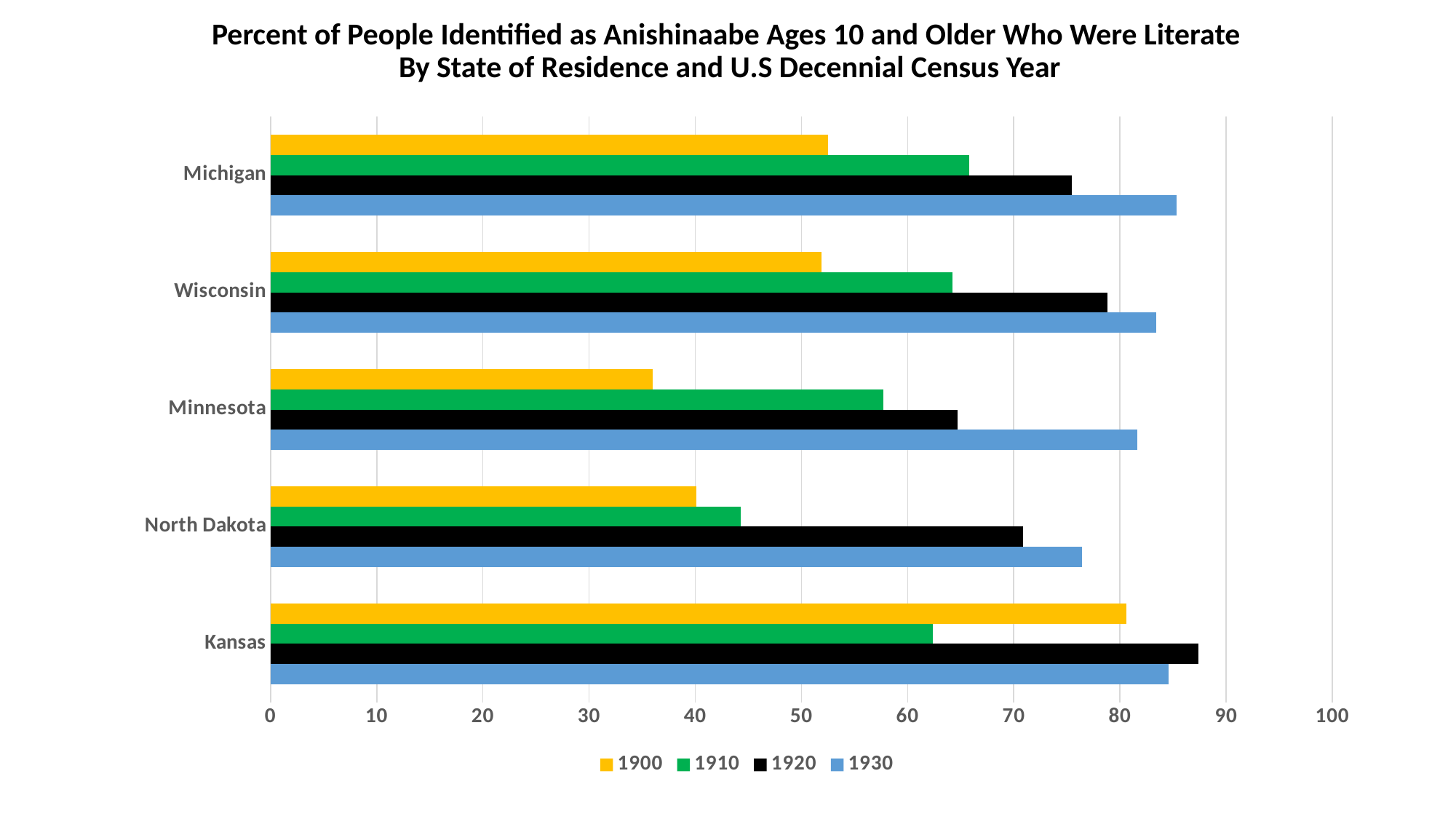
Which state has the highest 1900 value? Kansas Is the 1910 value for North Dakota greater or less than 50? less Which is larger, the 1920 value for Michigan or the 1920 value for Wisconsin? Wisconsin For Kansas, which is larger, the 1900 value or the 1910 value? 1900 Which colour represents the 1920 series in the legend? black Is the 1900 value for Minnesota greater or less than 40? less Which state has the lowest 1930 value? North Dakota What kind of chart is shown on the slide? bar chart How many states are shown on the chart? 5 Is the 1920 value for Kansas greater or less than 80? greater Which state has the lowest 1900 value? Minnesota How many series does the legend list? 4